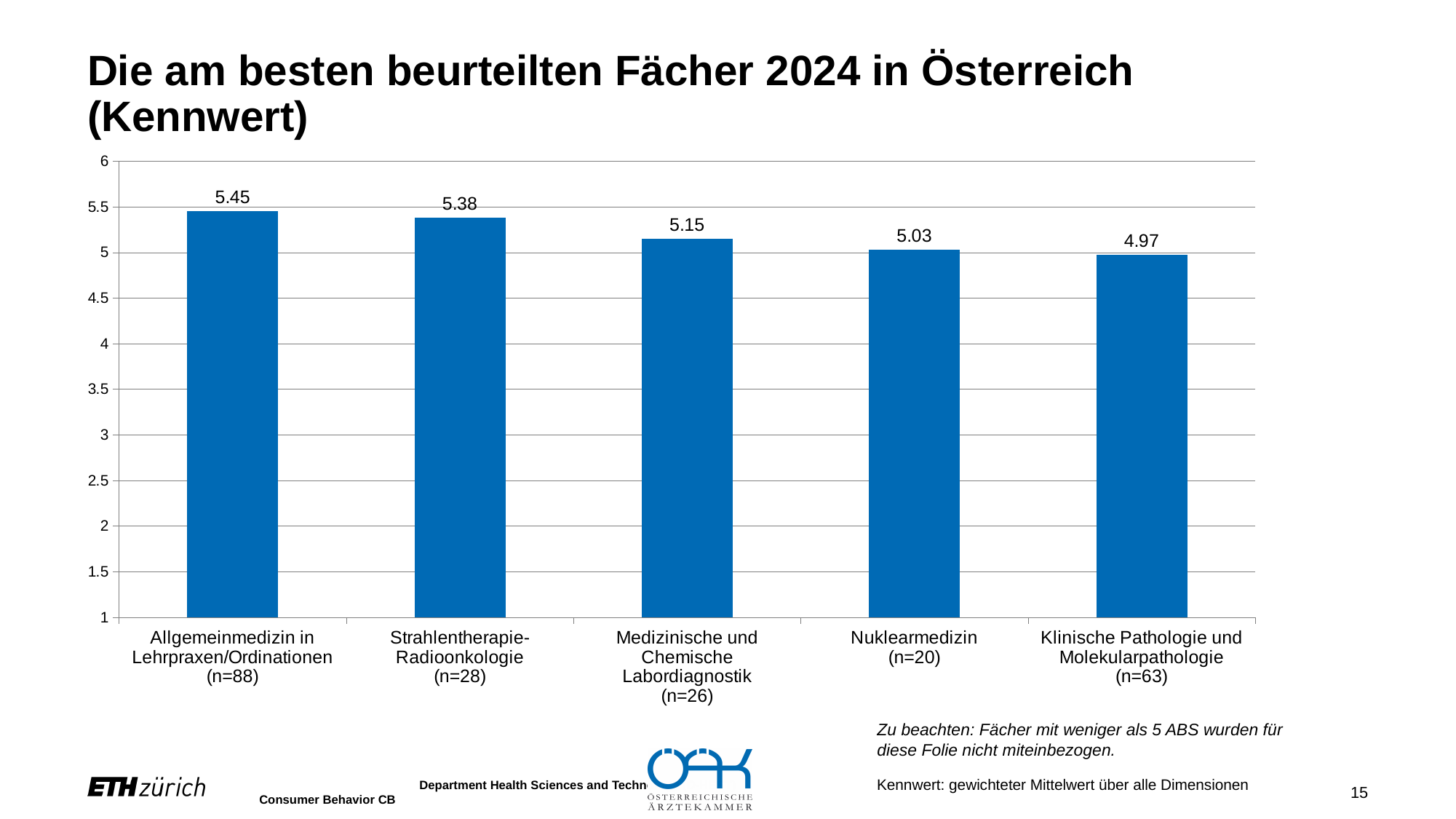
What is the Kennwert for Strahlentherapie-Radioonkologie (n=28)? 5.38 What kind of chart is shown on the slide? Bar chart What is the Kennwert for Nuklearmedizin (n=20)? 5.03 Which subject has the lowest Kennwert? Klinische Pathologie und Molekularpathologie How many subjects are shown in the chart? 5 Which has a higher Kennwert, Medizinische und Chemische Labordiagnostik or Nuklearmedizin? Medizinische und Chemische Labordiagnostik Which subject has the highest Kennwert? Allgemeinmedizin in Lehrpraxen/Ordinationen What is the difference between the Kennwert of Allgemeinmedizin in Lehrpraxen/Ordinationen and that of Klinische Pathologie und Molekularpathologie? 0.48 What is the Kennwert for Allgemeinmedizin in Lehrpraxen/Ordinationen (n=88)? 5.45 What is the difference between the Kennwert of Strahlentherapie-Radioonkologie and that of Medizinische und Chemische Labordiagnostik? 0.23 Do the values rise or fall from left to right across the chart? Fall What is the Kennwert for Klinische Pathologie und Molekularpathologie (n=63)? 4.97